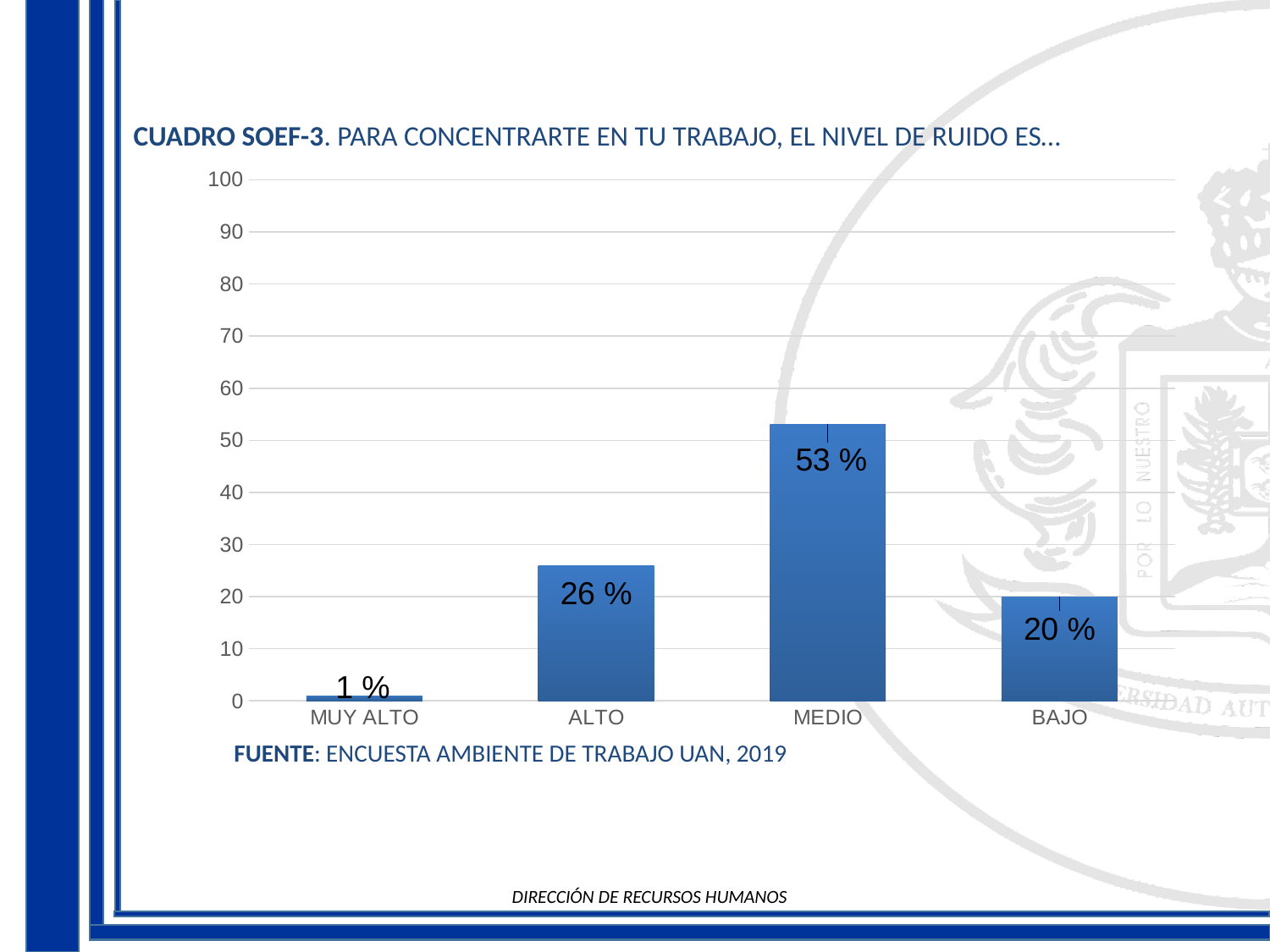
What is the value for MEDIO? 53 % What is the value for MUY ALTO? 1 % What kind of chart is shown on the slide? bar chart Which category has the highest value? MEDIO What is the difference between the values for MEDIO and ALTO? 27 % Which category has the lowest value? MUY ALTO What is the value for ALTO? 26 % Which is larger, the value for ALTO or the value for BAJO? ALTO What is the value for BAJO? 20 % How many categories are shown on the x axis? 4 Is the value for MEDIO greater or less than 50? greater What is the difference between the values for ALTO and BAJO? 6 %